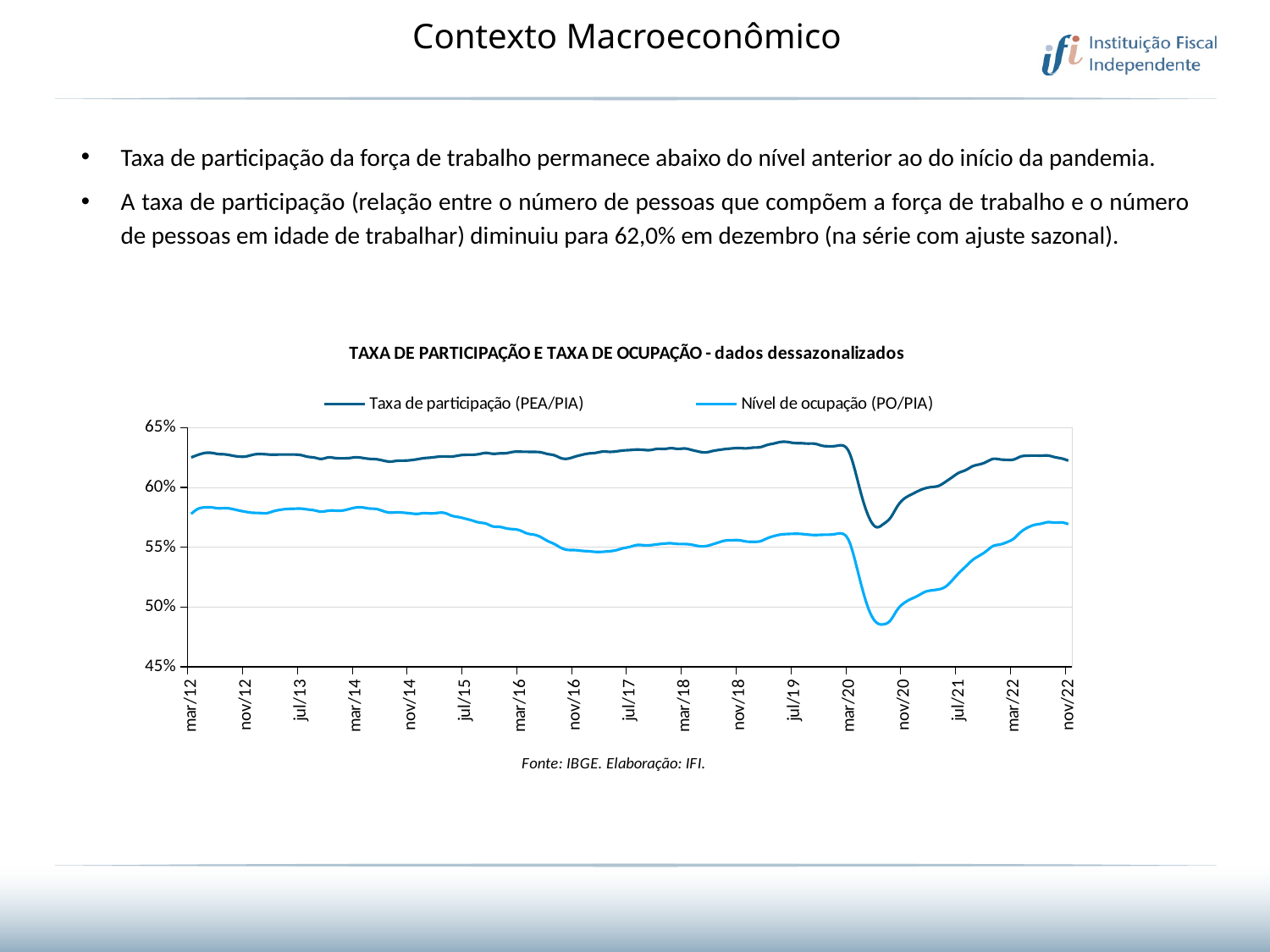
How many series does the chart's legend list? 2 What kind of chart is shown on the slide? Line chart What is the title of the chart? TAXA DE PARTICIPAÇÃO E TAXA DE OCUPAÇÃO - dados dessazonalizados Is the value of Nível de ocupação (PO/PIA) at mar/12 greater or less than 60%? less Is the value of Nível de ocupação (PO/PIA) at nov/20 greater or less than 55%? less Is the value of Nível de ocupação (PO/PIA) at nov/22 greater or less than 55%? greater Does the Nível de ocupação (PO/PIA) series rise or fall between mar/20 and nov/20? Fall Which two series are listed in the chart's legend? Taxa de participação (PEA/PIA) and Nível de ocupação (PO/PIA) Which series has the higher value at mar/20, Taxa de participação (PEA/PIA) or Nível de ocupação (PO/PIA)? Taxa de participação (PEA/PIA) Does the Taxa de participação (PEA/PIA) series rise or fall between nov/20 and nov/22? Rise